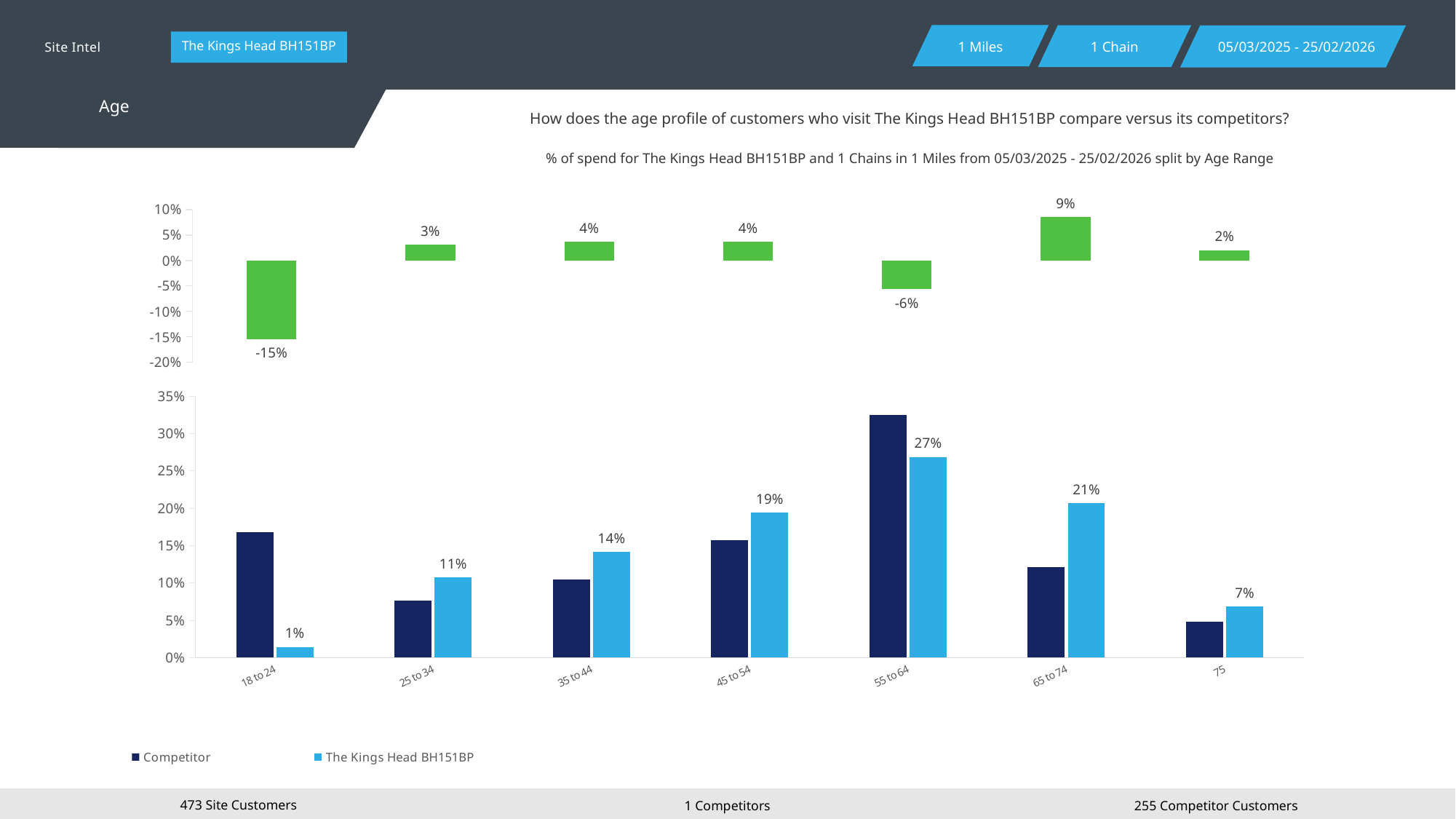
In the bottom chart, is the Competitor value for 55 to 64 greater or less than 30%? greater How many series does the legend of the bottom chart list? 2 In the bottom chart, which age range has the highest value for The Kings Head BH151BP? 55 to 64 In the top chart, what is the value shown for the 18 to 24 age range? -15% In the top chart, which age range has the lowest value? 18 to 24 In the top chart, what is the value shown for the 55 to 64 age range? -6% In the bottom chart, what is the difference between The Kings Head BH151BP values for 55 to 64 and 65 to 74? 6% In the bottom chart, what is the value for The Kings Head BH151BP in the 55 to 64 age range? 27% In the top chart, which age range has the highest value? 65 to 74 How many age range categories are shown on the x axis of the bottom chart? 7 In the bottom chart, is the Competitor value for 18 to 24 greater or less than 15%? greater In the bottom chart, for the 18 to 24 age range, which series has the larger value: Competitor or The Kings Head BH151BP? Competitor